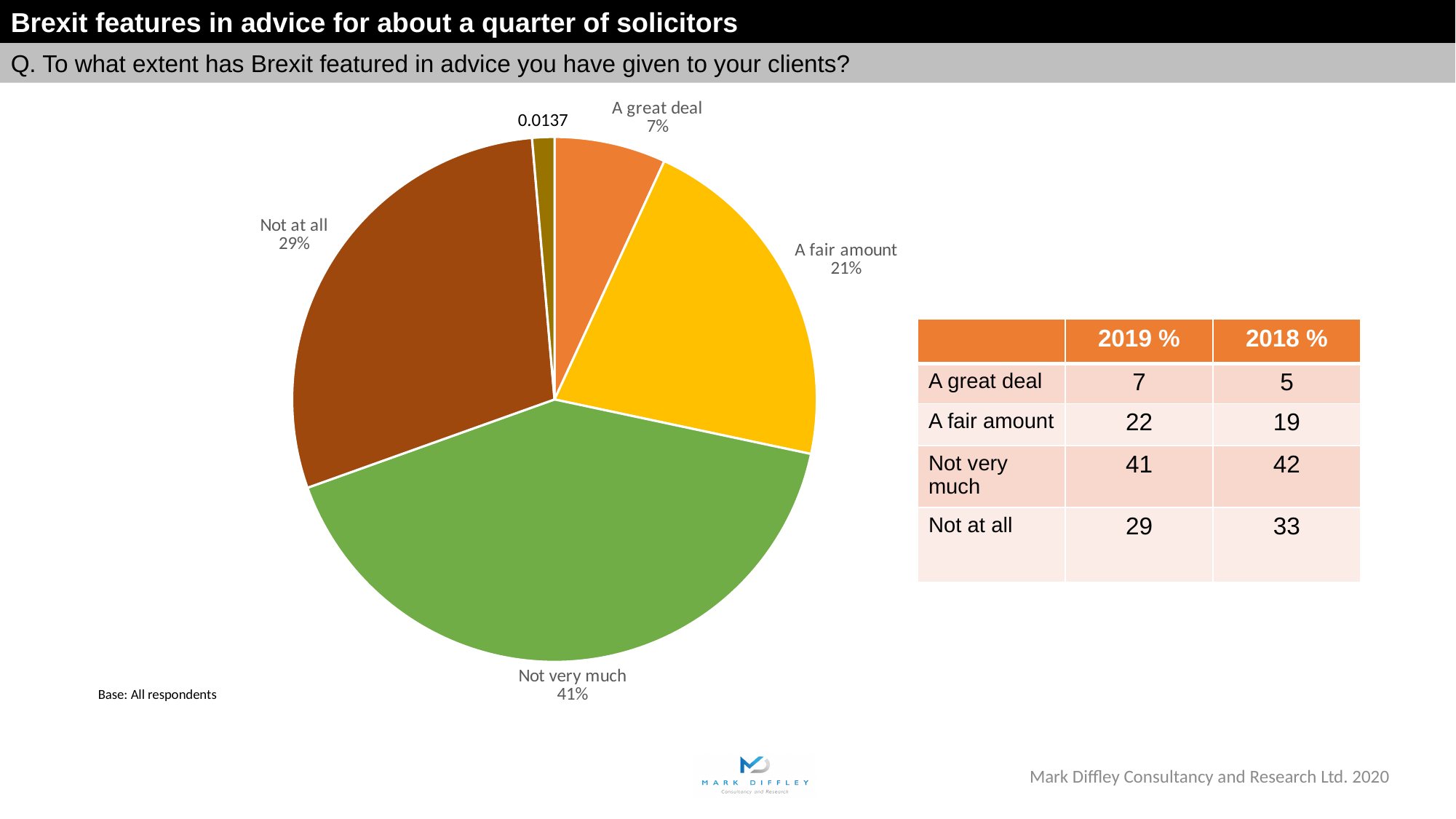
What is the value shown for "A fair amount" in the pie chart? 21% What is the value shown for "A great deal" in the pie chart? 7% Which labelled category has the largest slice of the pie chart? Not very much What kind of chart is shown on the slide? pie chart Which named category has the smallest slice of the pie chart? A great deal What colour is the "Not very much" slice of the pie chart? green What share of the pie does "Not very much" represent? 41% How many slices does the pie chart have? 5 What is the difference between the "Not very much" and "Not at all" shares in the pie chart? 12% What is the difference between the "A fair amount" and "A great deal" shares in the pie chart? 14% Which is larger in the pie chart, "A fair amount" or "A great deal"? A fair amount What is the value shown for "Not at all" in the pie chart? 29%